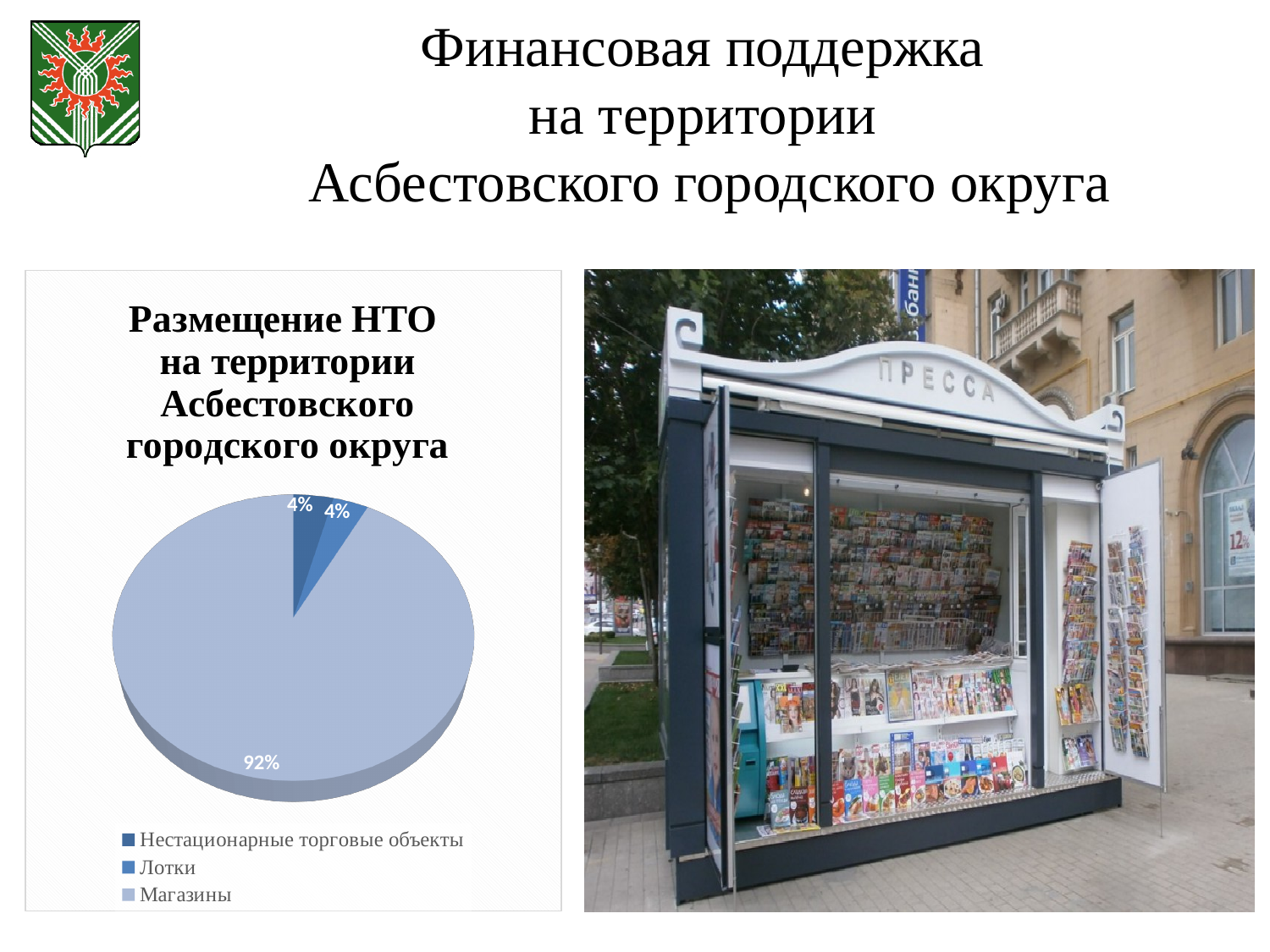
By how many percentage points does the Магазины slice exceed the Лотки slice? 88 Which legend entry is listed first in the pie chart's legend? Нестационарные торговые объекты What is the value shown for Лотки in the pie chart? 4% Which category has the largest slice in the pie chart? Магазины How many entries does the legend of the pie chart list? 3 What kind of chart is shown on the slide? pie chart How many slices does the pie chart have? 3 Which is larger in the pie chart, Магазины or Лотки? Магазины What is the title of the chart on the slide? Размещение НТО на территории Асбестовского городского округа What is the value shown for Нестационарные торговые объекты in the pie chart? 4% What share of the pie does Магазины account for? 92%